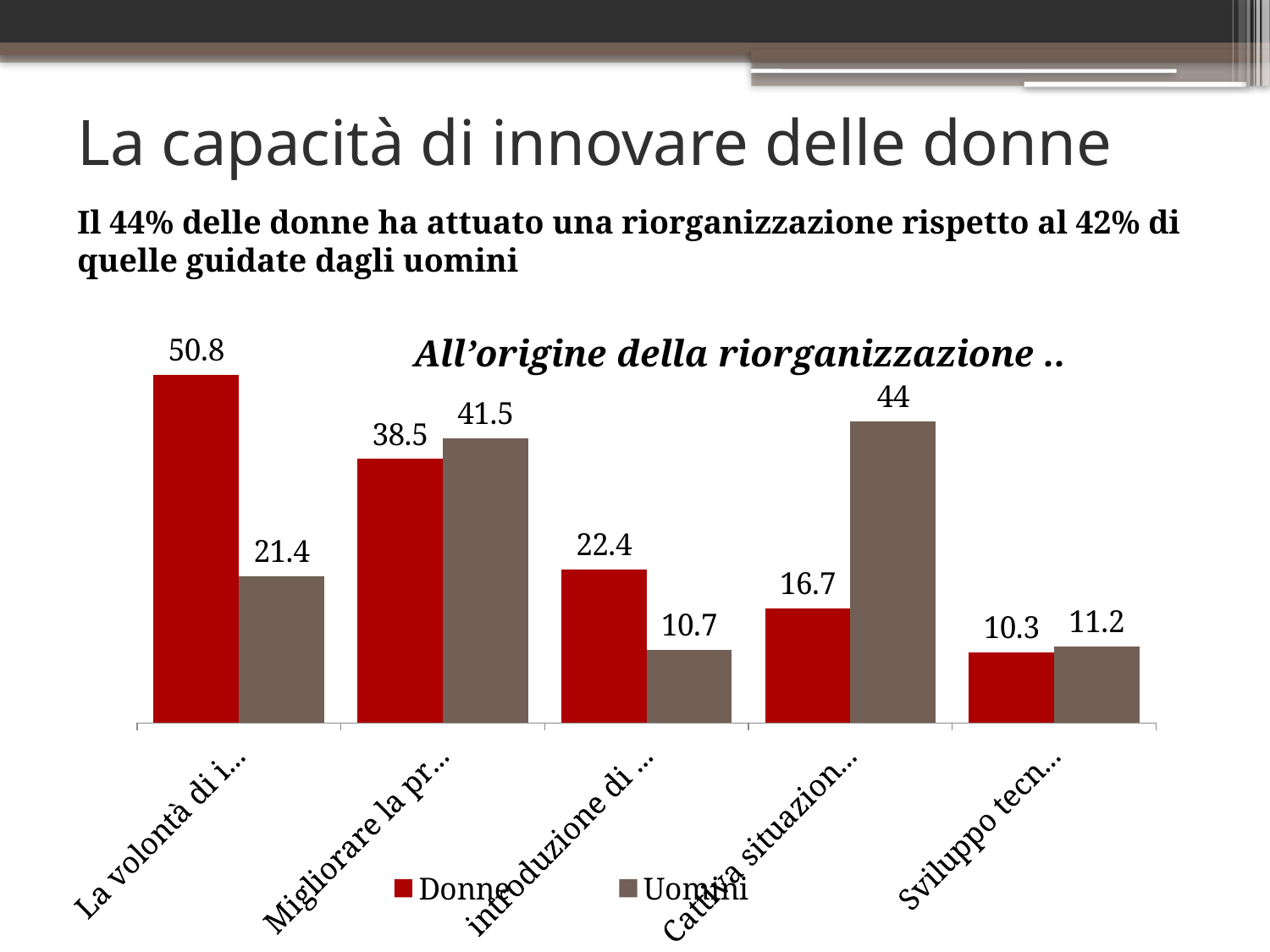
How many categories are shown on the x axis? 5 How many series does the legend list? 2 What is the value of the Donne series for the last category (Sviluppo tecn...)? 10.3 What is the value of the Donne series for the first category (La volontà di i...)? 50.8 Do the Donne values rise or fall from left to right along the x axis? Fall What is the value of the Uomini series for the fourth category (Cattiva situazion...)? 44 What kind of chart is shown on the slide? Bar chart Which category has the highest Donne value? The first category (La volontà di i...) What is the difference between the Uomini and Donne values for the fourth category (Cattiva situazion...)? 27.3 What is the difference between the Donne and Uomini values for the first category (La volontà di i...)? 29.4 Which category has the lowest Uomini value? The third category (introduzione di ...) For the second category (Migliorare la pr...), which series has the larger value, Donne or Uomini? Uomini